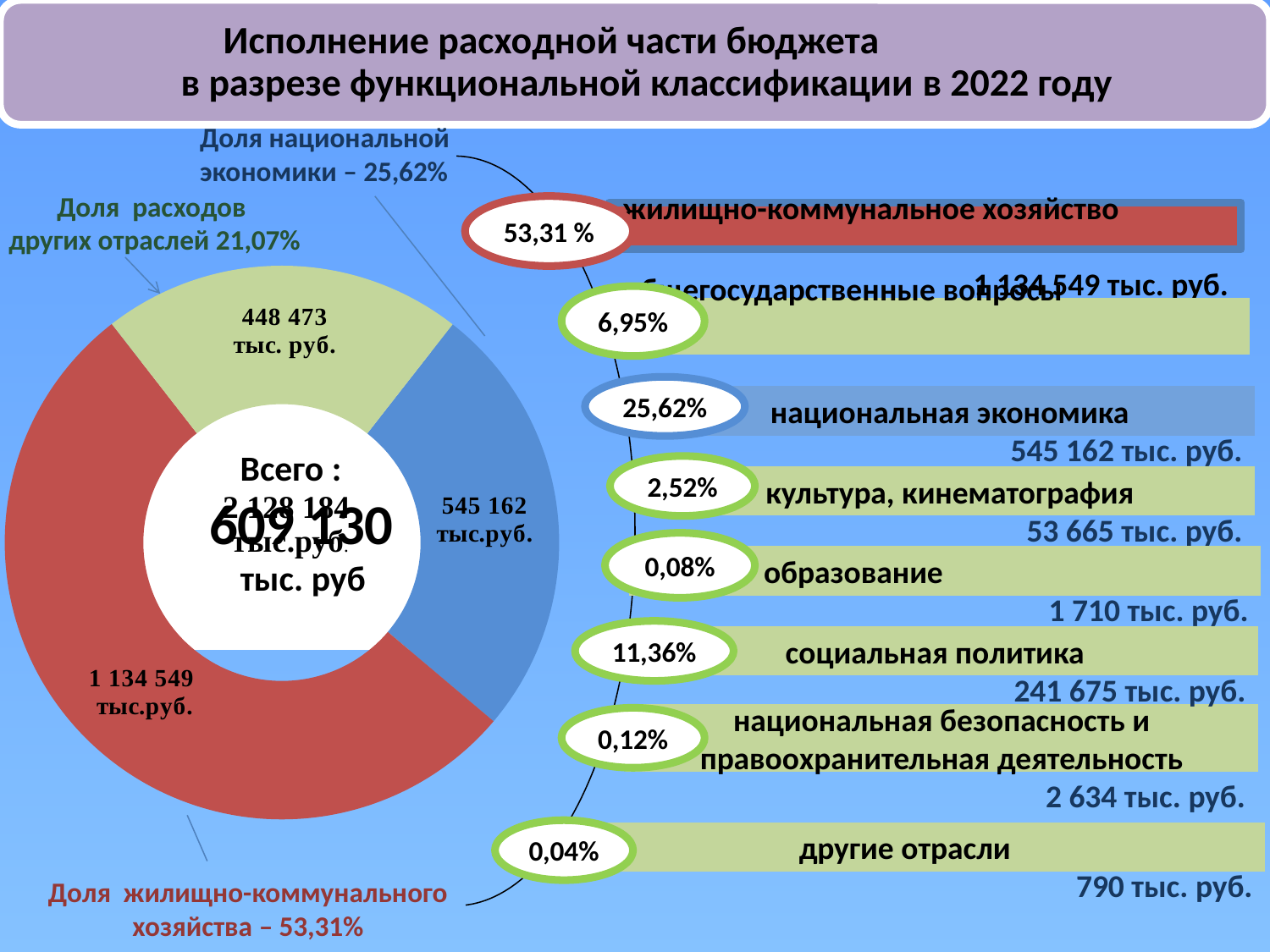
What share of the doughnut chart does жилищно-коммунальное хозяйство account for? 53,31% In the doughnut chart, what is the value of the другие отрасли slice? 448 473 тыс. руб. How many slices does the doughnut chart have? 3 In the doughnut chart, which slice is larger: национальная экономика or другие отрасли? Национальная экономика In the doughnut chart, what is the value of the национальная экономика slice? 545 162 тыс.руб. Which slice of the doughnut chart is the smallest? Другие отрасли In the doughnut chart, what is the value of the жилищно-коммунальное хозяйство slice? 1 134 549 тыс.руб. Which slice of the doughnut chart is the largest? Жилищно-коммунальное хозяйство What share of the doughnut chart does национальная экономика account for? 25,62% In the doughnut chart, what is the difference between the жилищно-коммунальное хозяйство value and the национальная экономика value? 589 387 тыс. руб. What kind of chart is shown on the left of the slide? Doughnut (pie) chart What share of the doughnut chart do расходы других отраслей account for? 21,07%